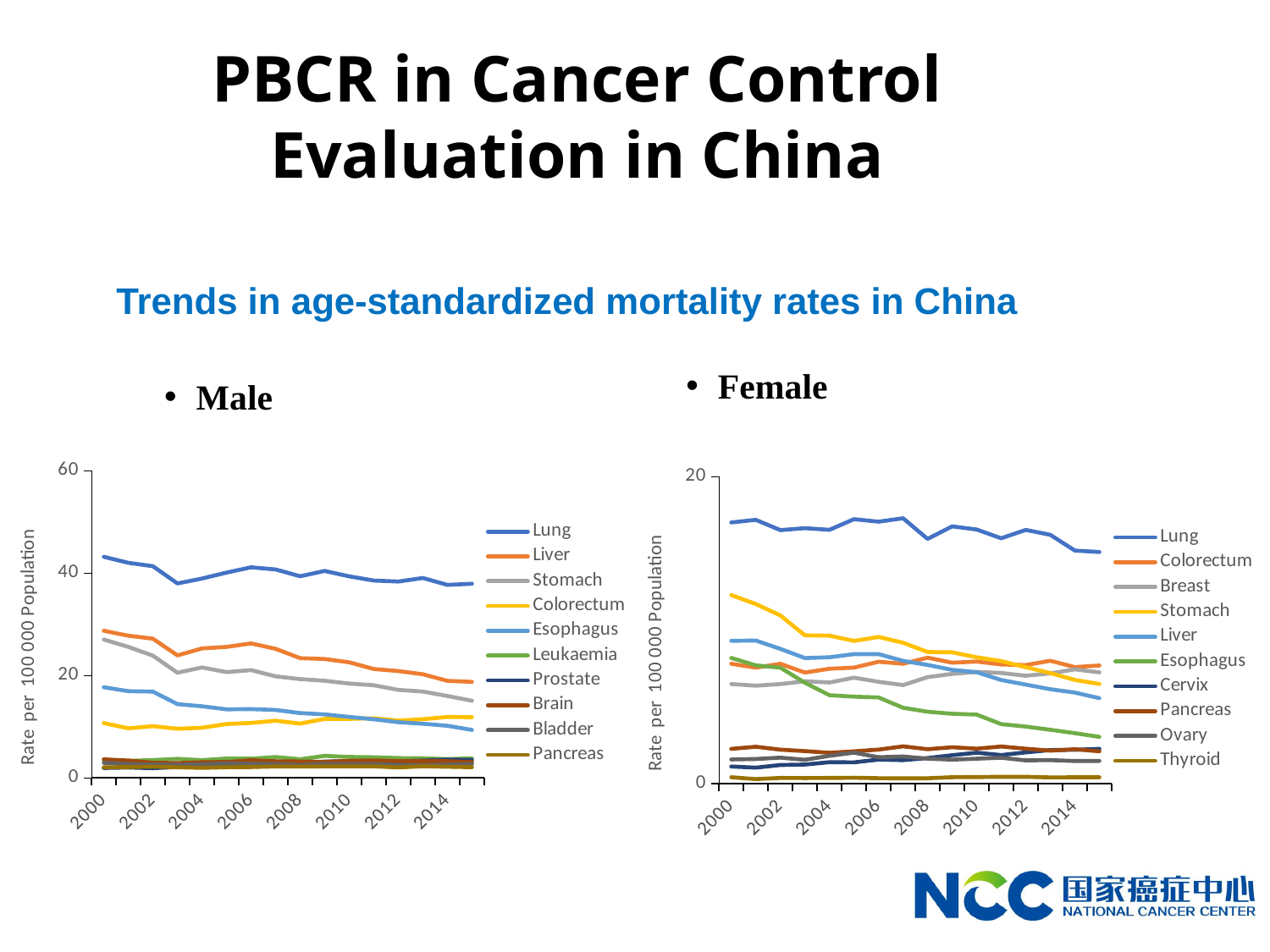
In the Male chart, does the Stomach mortality rate rise or fall from 2000 to 2015? fall What is the y-axis label of the Male chart? Rate per 100 000 Population In the Male chart, is the Liver mortality rate in 2000 greater or less than 20? greater In the Male chart, which is higher in 2000, Liver or Esophagus? Liver In the Female chart, does the Stomach mortality rate rise or fall from 2000 to 2015? fall In the Female chart, which cancer site has the lowest mortality rate across the years shown? Thyroid What kind of chart is the Male chart? line chart How many series does the legend of the Male chart list? 10 In the Female chart, which cancer site has the highest mortality rate across the years shown? Lung How many series does the legend of the Female chart list? 10 In the Male chart, is the Lung mortality rate in 2000 greater or less than 40? greater In the Male chart, which cancer site has the highest mortality rate across the years shown? Lung